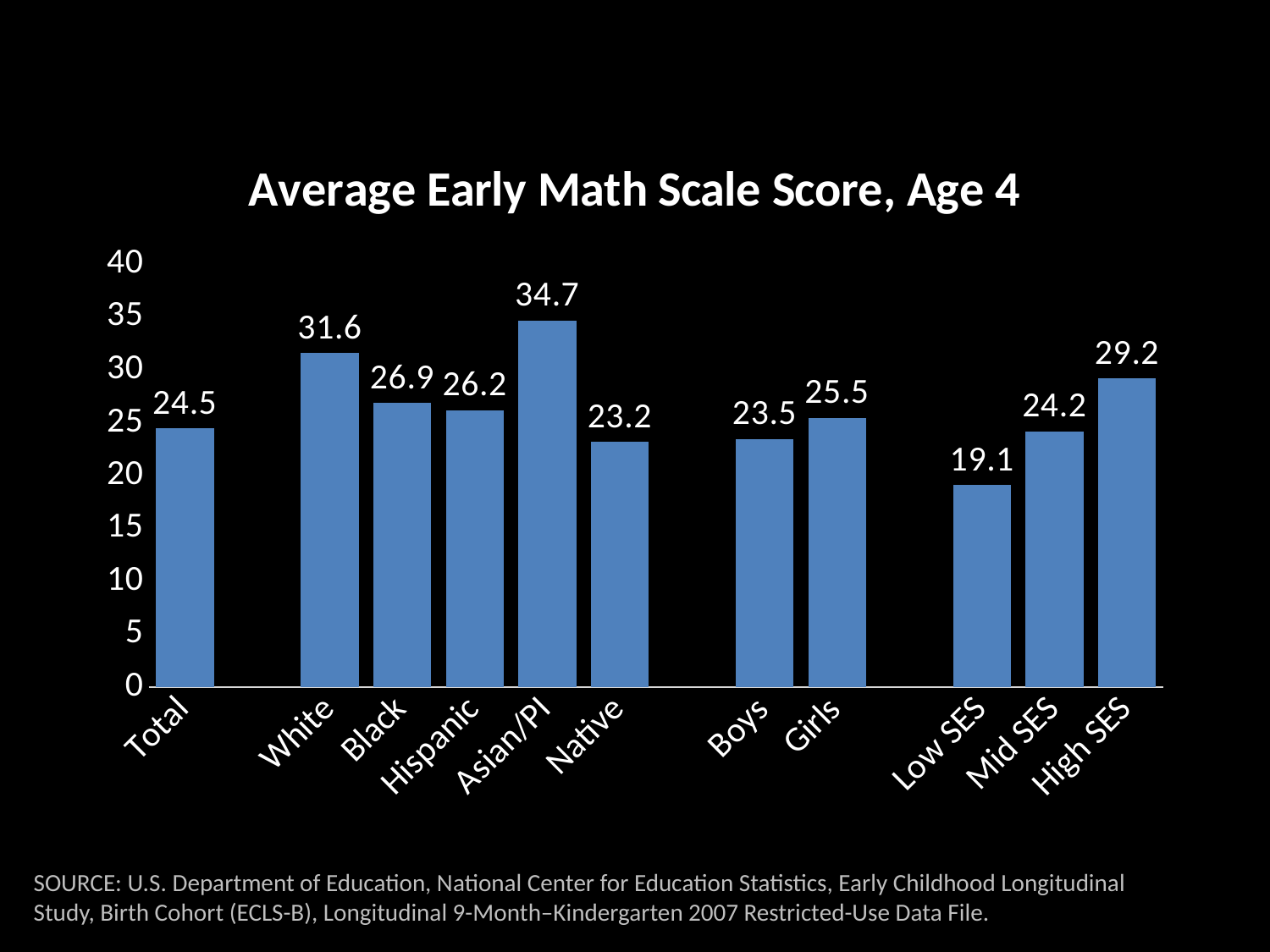
What kind of chart is shown on the slide? bar chart What is the title of the chart? Average Early Math Scale Score, Age 4 What is the difference between the scores for White and Black children? 4.7 Which category has the highest average early math scale score? Asian/PI Which category has the lowest average early math scale score? Low SES What is the difference between the scores for High SES and Low SES? 10.1 What is the value shown for Girls? 25.5 How many categories are shown on the x axis? 11 Is the value for Native greater or less than 25? less What is the average early math scale score for Asian/PI children? 34.7 What is the value shown for Low SES? 19.1 Which is larger, the score for Boys or the score for Girls? Girls